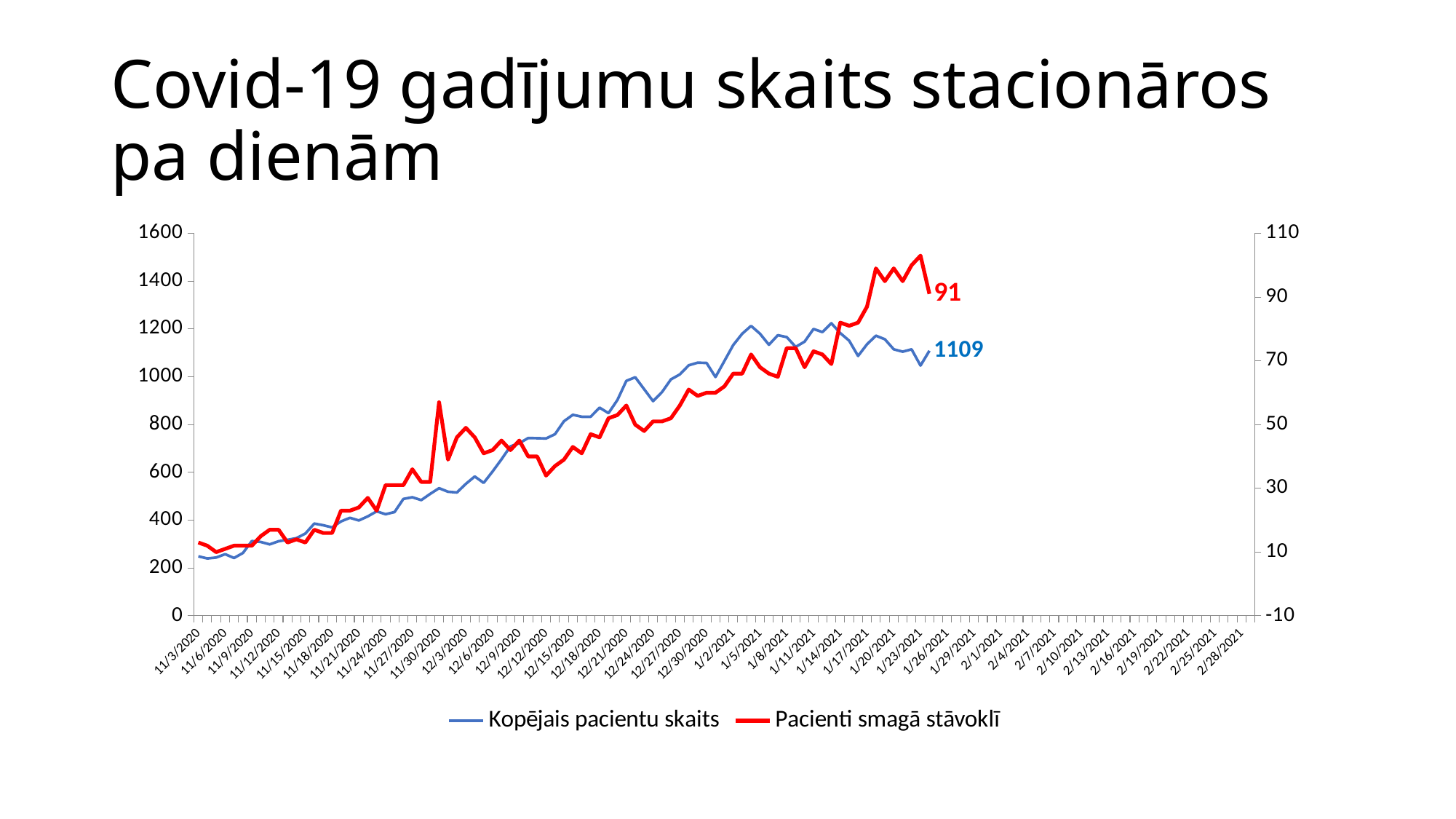
How many series does the legend list? 2 What kind of chart is shown on the slide? line chart What is the title of the chart on the slide? Covid-19 gadījumu skaits stacionāros pa dienām What is the last labelled value of the Kopējais pacientu skaits series? 1109 What colour is the line for Pacienti smagā stāvoklī? red Is the value for Kopējais pacientu skaits at 1/5/2021 greater or less than 1000 on the left axis? greater Is the value for Kopējais pacientu skaits at 11/3/2020 greater or less than 400 on the left axis? less Does the Pacienti smagā stāvoklī series generally rise or fall from 11/3/2020 to 1/23/2021? rise Is the value for Pacienti smagā stāvoklī at 1/20/2021 greater or less than 70 on the right axis? greater Does the Kopējais pacientu skaits series generally rise or fall from 11/3/2020 to 1/14/2021? rise What is the last labelled value of the Pacienti smagā stāvoklī series? 91